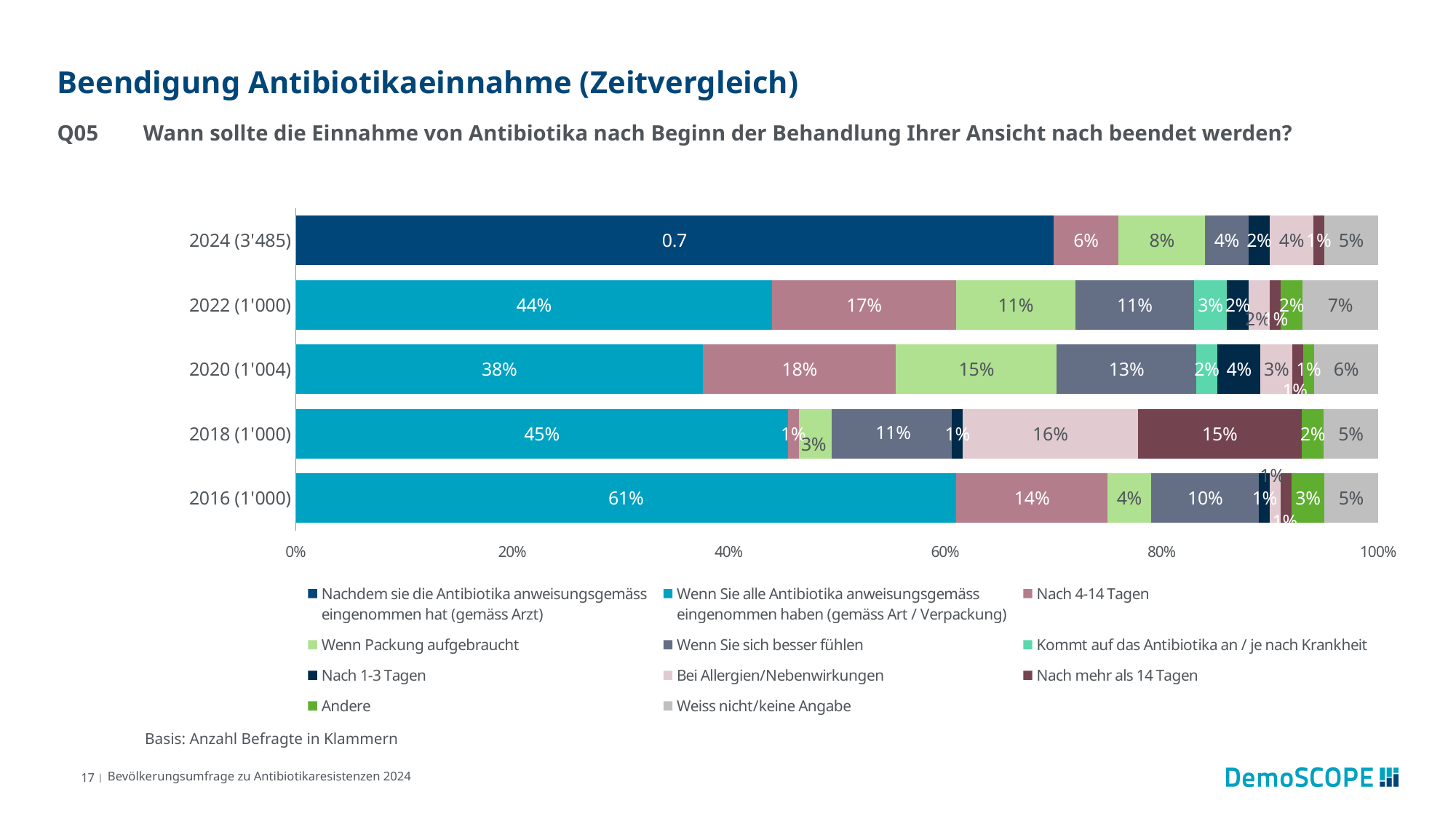
What is the value for "Bei Allergien/Nebenwirkungen" in 2018 (1'000)? 16% Which year has the highest value for "Nach mehr als 14 Tagen"? 2018 (1'000) How many series does the legend list? 11 Which year has the highest value for "Weiss nicht/keine Angabe"? 2022 (1'000) How many years (bars) are shown in the chart? 5 Which year has the larger value for "Wenn Packung aufgebraucht", 2022 (1'000) or 2020 (1'004)? 2020 (1'004) What is the value for "Nach 4-14 Tagen" in 2022 (1'000)? 17% What is the value for "Wenn Sie alle Antibiotika anweisungsgemäss eingenommen haben (gemäss Art / Verpackung)" in 2016 (1'000)? 61% What kind of chart is shown on the slide? Stacked bar chart What is the value for "Wenn Sie sich besser fühlen" in 2020 (1'004)? 13% What is the difference between the "Nach 4-14 Tagen" values for 2020 (1'004) and 2024 (3'485)? 12 percentage points What is the value for "Weiss nicht/keine Angabe" in 2024 (3'485)? 5%